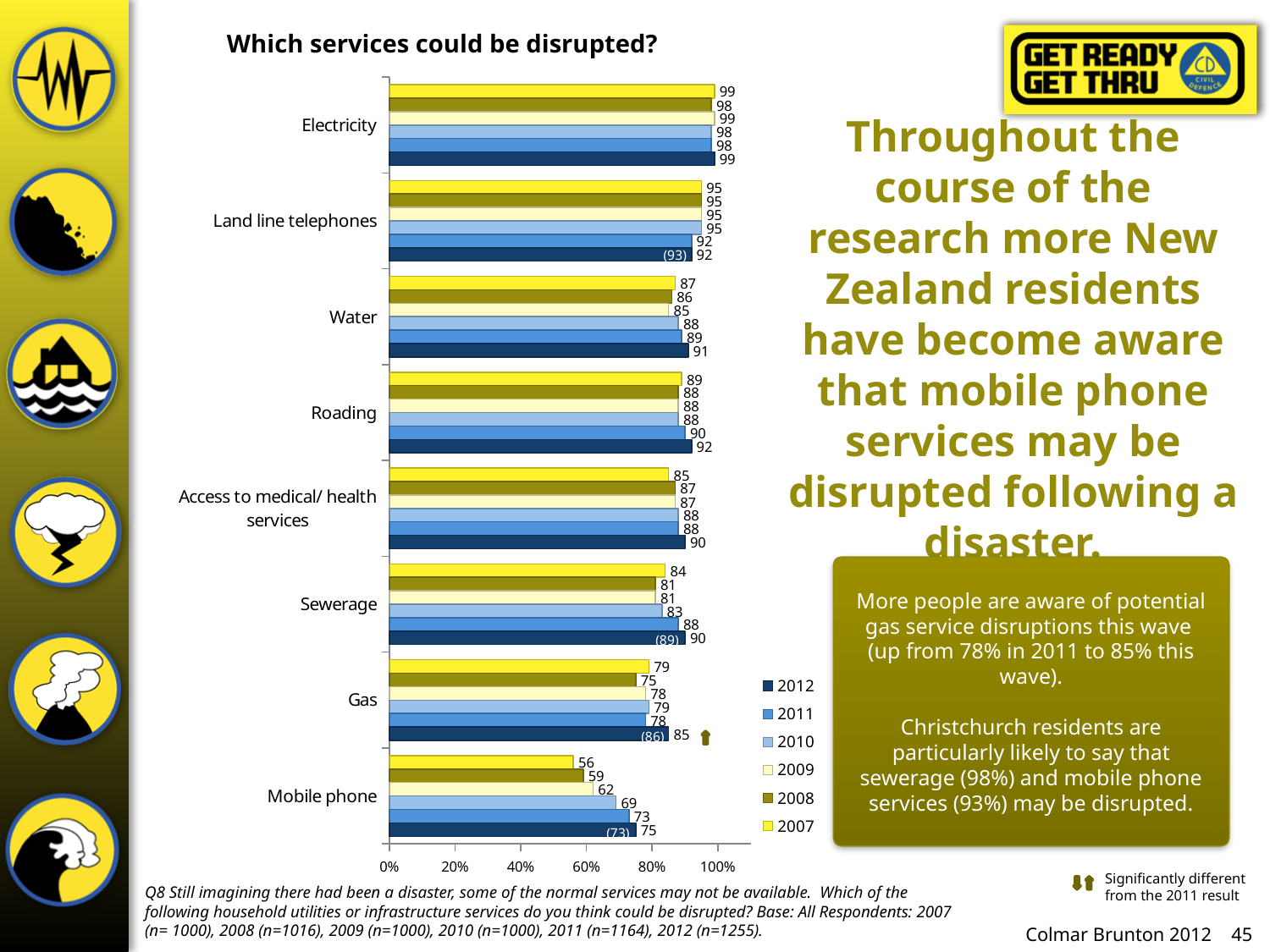
What is the 2012 value for Gas? 85 Which service has the lowest 2012 value? Mobile phone What is the 2012 value for Mobile phone? 75 What is the 2007 value for Mobile phone? 56 How many years (series) does the legend list? 6 What type of chart is shown on the slide? Bar chart Which is larger in 2012: the value for Sewerage or the value for Gas? Sewerage How many services (categories) are shown on the chart? 8 Do the Mobile phone values rise or fall from 2007 to 2012? Rise Which service has the highest 2012 value? Electricity What is the 2012 value for Electricity? 99 By how much did the Mobile phone value increase from 2007 to 2012? 19